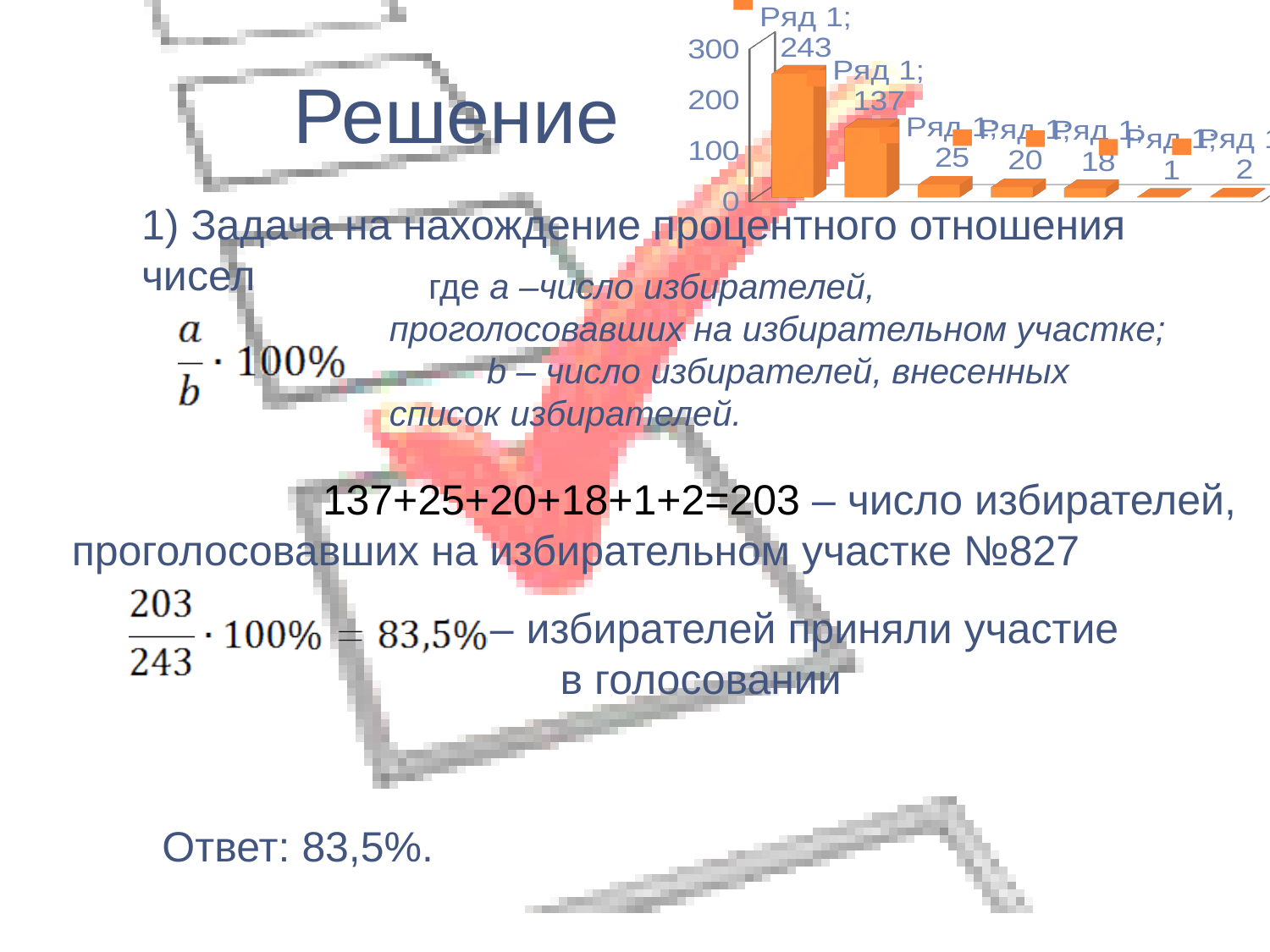
Which is larger, the fourth bar or the fifth bar? the fourth bar (20) What is the difference between the first bar (243) and the second bar (137)? 106 Is the value of the first bar greater or less than 200? greater What is the lowest value shown in the chart? 1 What is the value of the second bar in the chart? 137 What is the value of the third bar in the chart? 25 How many bars are plotted in the chart? 7 What kind of chart is shown at the top right of the slide? bar chart What is the value of the fifth bar in the chart? 18 What is the highest value shown in the chart? 243 What series name appears in the data labels of the chart? Ряд 1 What is the value of the first (tallest) bar in the chart? 243